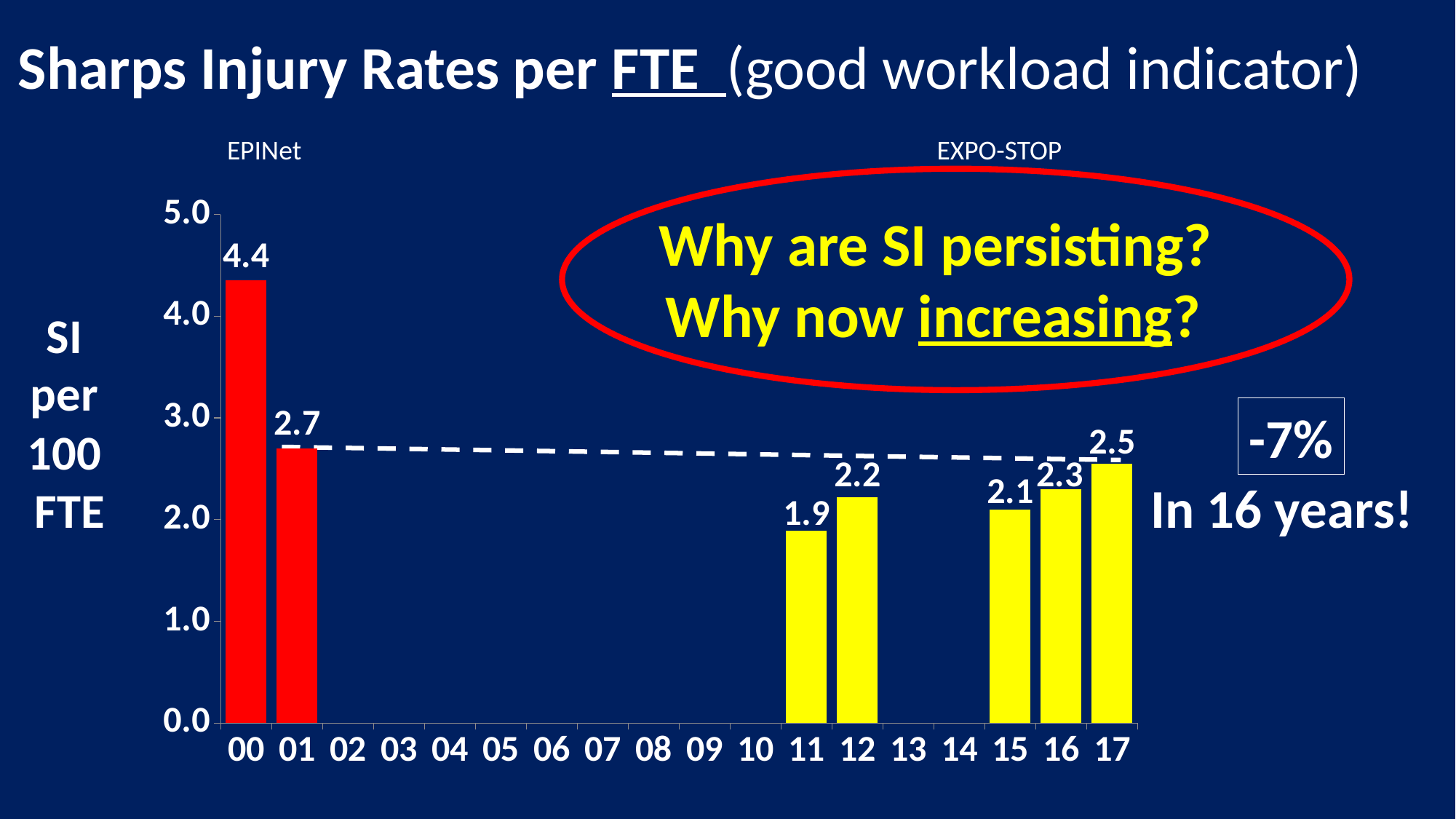
What is the sharps injury rate per 100 FTE for the year 17? 2.5 Which year has the highest sharps injury rate? 00 Is the value for the year 16 greater or less than 2.0? greater How many bars are plotted on the chart? 7 What is the difference between the rate in 00 and the rate in 01? 1.7 What kind of chart is shown on the slide? bar chart What is the sharps injury rate per 100 FTE for the year 00? 4.4 What is the value shown for the year 11? 1.9 Do the values rise or fall from year 15 to year 17? rise What is the difference between the rate in 17 and the rate in 11? 0.6 Which year has a higher rate, 12 or 15? 12 Which year has the lowest sharps injury rate? 11